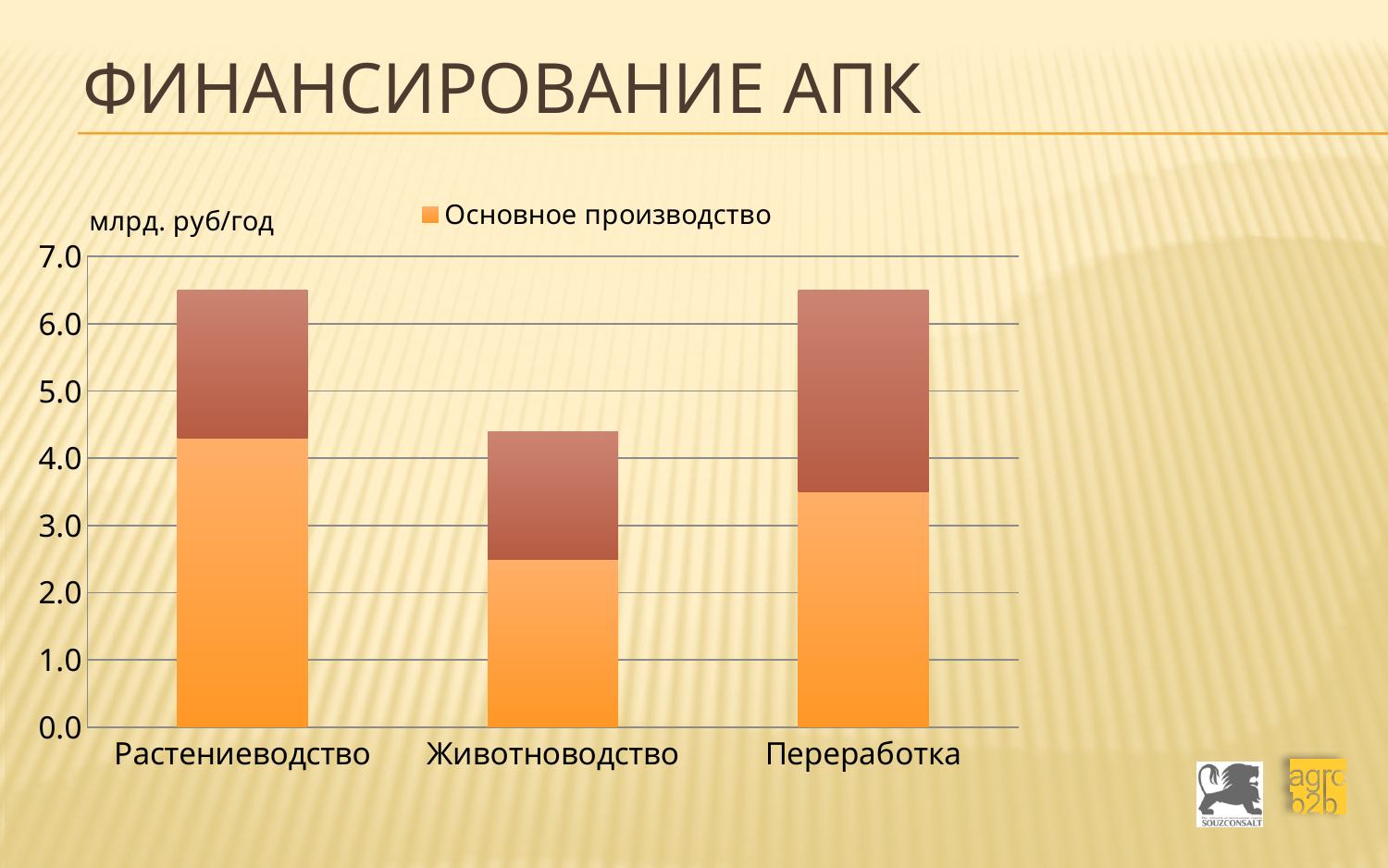
Which category has the lowest total bar height? Животноводство Which category has the largest Основное производство (orange) segment? Растениеводство What kind of chart is shown on the slide? Stacked bar chart How many series does the chart's legend list? 1 Is the total bar for Растениеводство greater or less than 6.0? greater Which is larger, the Основное производство segment for Переработка or for Животноводство? Переработка Is the total bar for Животноводство greater or less than 5.0? less Which category has the smallest Основное производство (orange) segment? Животноводство What unit is shown above the y axis of the chart? млрд. руб/год Is the Основное производство value for Растениеводство greater or less than 4.0? greater How many categories are shown on the x axis of the chart? 3